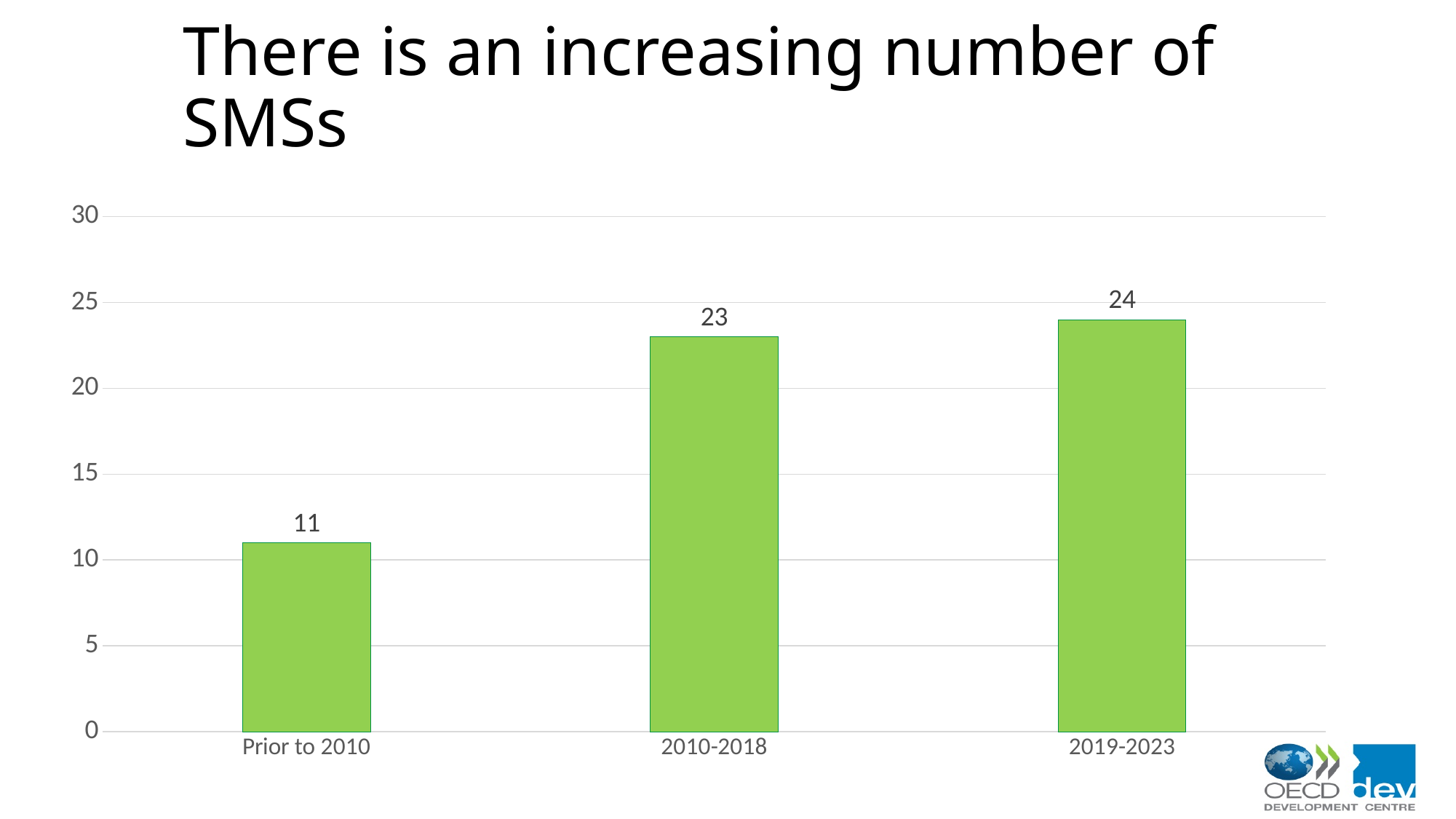
What is the difference between the values for 2019-2023 and 2010-2018? 1 What is the value for 2019-2023? 24 What is the value for Prior to 2010? 11 Which category has the highest value? 2019-2023 How many categories are shown on the x axis? 3 What kind of chart is shown on the slide? bar chart Which category has the lowest value? Prior to 2010 Which is larger, the value for Prior to 2010 or the value for 2010-2018? 2010-2018 What is the difference between the values for 2010-2018 and Prior to 2010? 12 Do the values rise or fall from left to right along the x axis? rise What is the value for 2010-2018? 23 Is the value for Prior to 2010 greater or less than 15? less